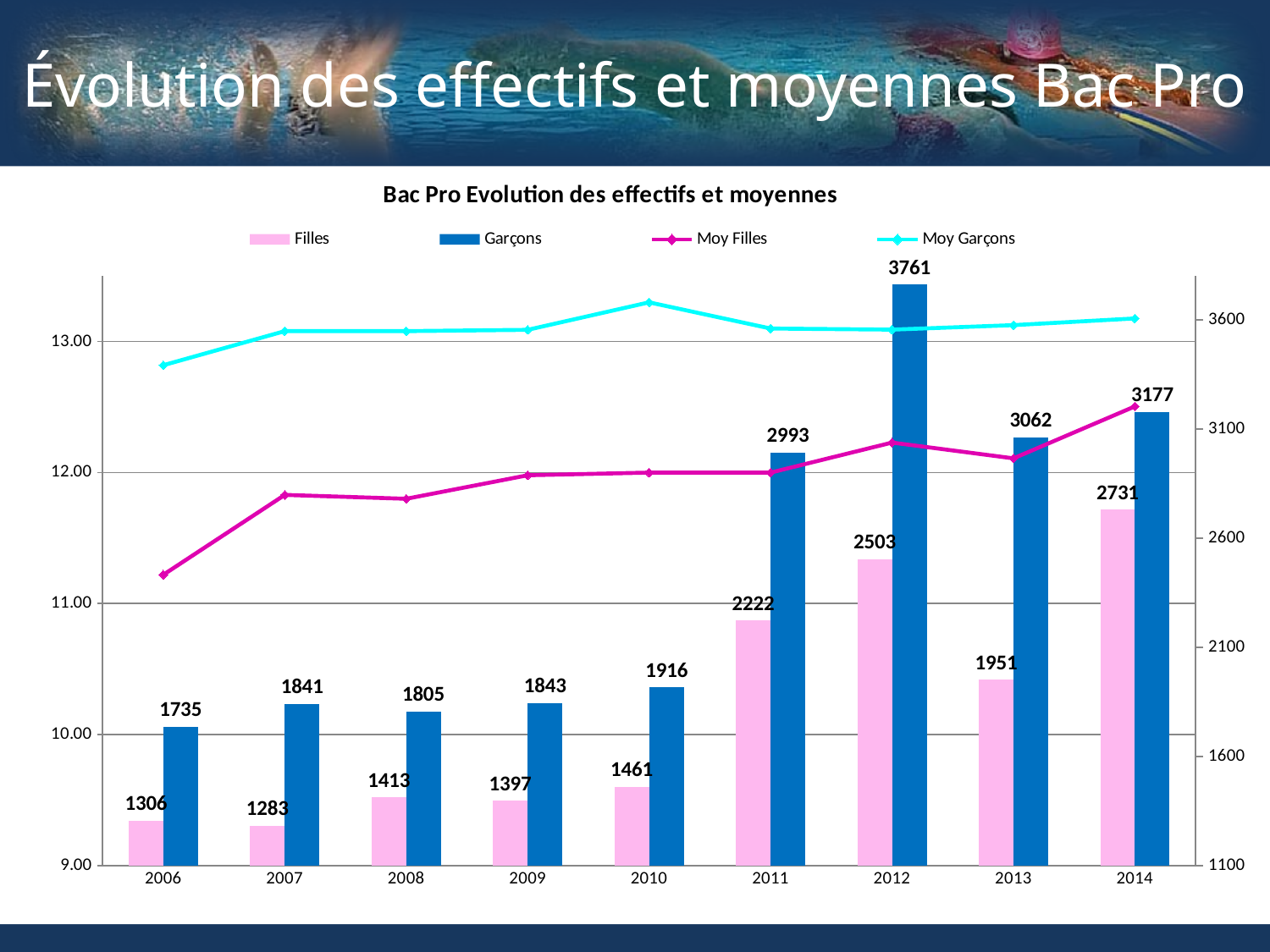
What is the difference between the Garçons and Filles values in 2012? 1258 Do the Garçons values rise or fall from 2006 to 2012? rise How many series does the legend list? 4 What is the value for Garçons in 2014? 3177 Which is larger: the Filles value in 2013 or in 2010? 2013 In which year is the Garçons value highest? 2012 What kind of chart is this? Combination bar and line chart Is the Moy Filles value for 2006 greater or less than 12.00? less What is the value for Filles in 2012? 2503 How many years are shown on the x axis? 9 In which year is the Filles value lowest? 2007 Is the Moy Garçons value for 2010 greater or less than 13.00? greater